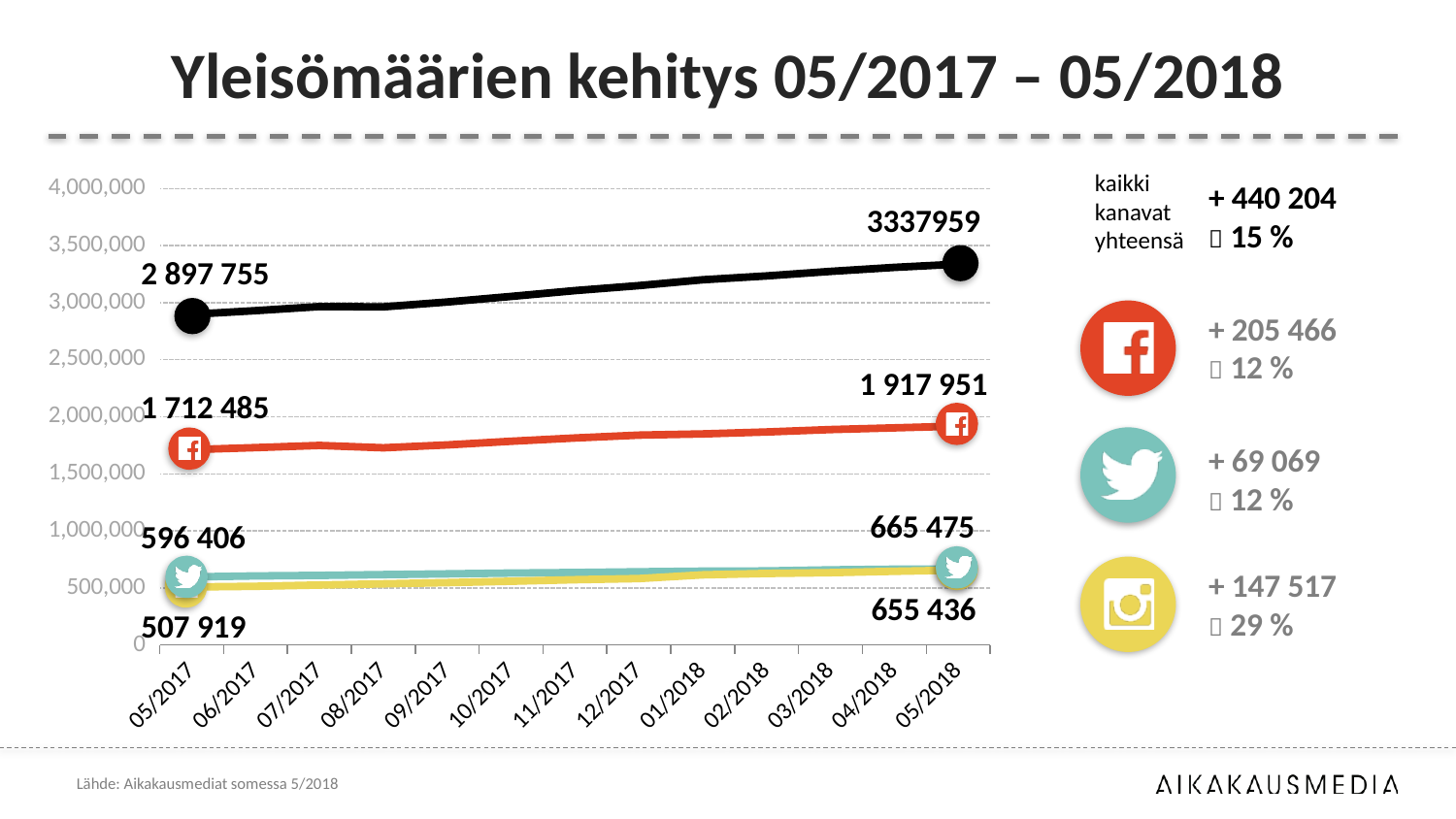
What kind of chart is shown on the slide? Line chart What is the value of the Instagram (yellow) line at 05/2017? 507 919 How many months are shown on the x axis? 13 What is the value of the Facebook line at 05/2017? 1 712 485 By how much did the black (total) line increase from 05/2017 to 05/2018? 440 204 Which series has the highest value at 05/2018? The black (total) line What is the value of the Twitter line at 05/2018? 665 475 What is the value of the black (total) line at 05/2018? 3337959 Does the black (total) line rise or fall from 05/2017 to 05/2018? Rise By how much did the Facebook line increase from 05/2017 to 05/2018? 205 466 At 05/2017, which is larger: the Twitter value or the Instagram value? Twitter Is the value of the Facebook line at 09/2017 greater or less than 2,000,000? less